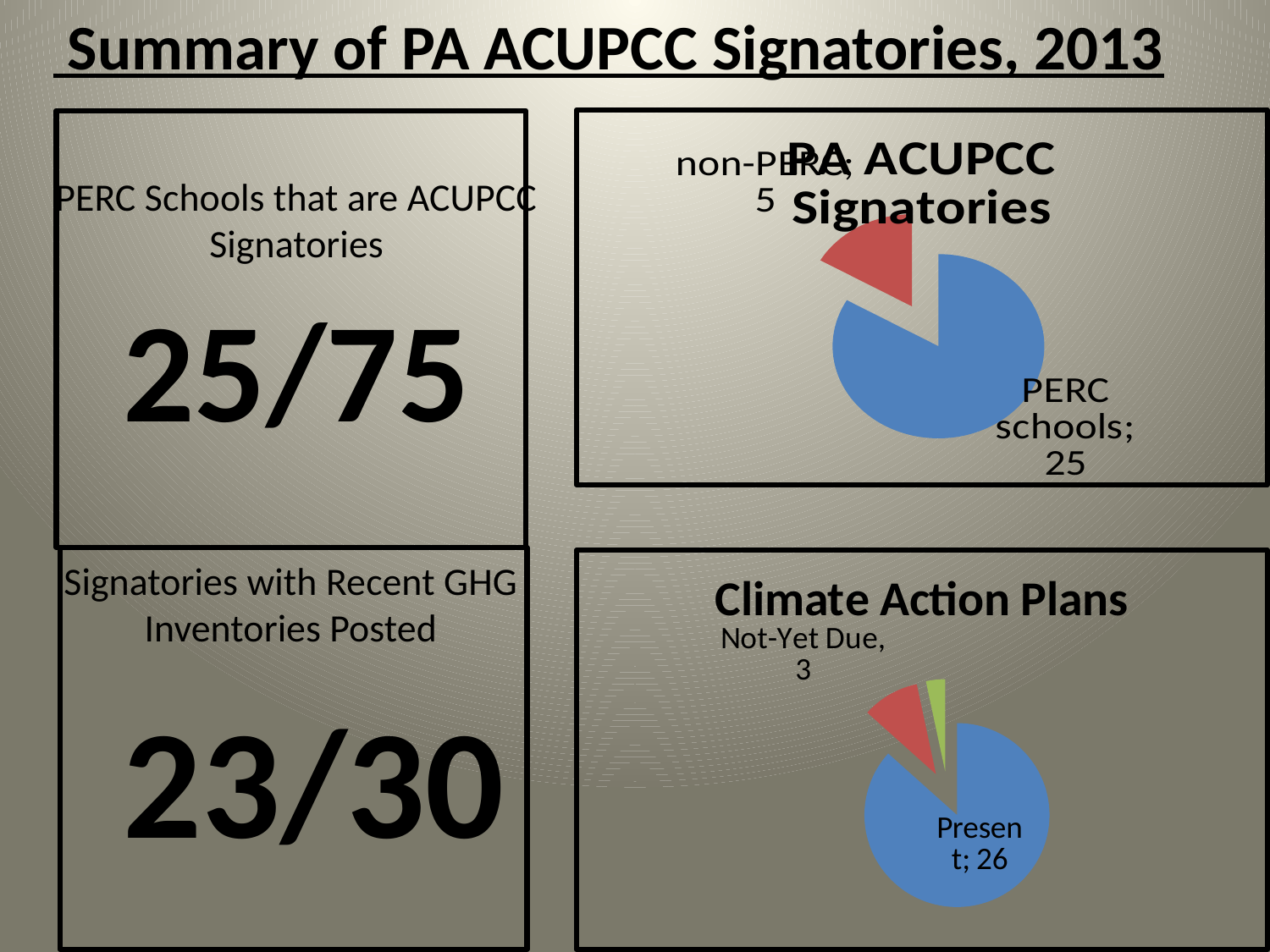
In the PA ACUPCC Signatories chart, which category has the largest slice? PERC schools In the PA ACUPCC Signatories chart, what is the value for non-PERC? 5 In the Climate Action Plans chart, what is the value for Not-Yet Due? 3 In the Climate Action Plans chart, what is the value for Present? 26 In the PA ACUPCC Signatories chart, what is the value for PERC schools? 25 What kind of chart is the PA ACUPCC Signatories chart? Pie chart In the Climate Action Plans chart, which is larger, Present or Not-Yet Due? Present In the Climate Action Plans chart, which category has the largest slice? Present In the PA ACUPCC Signatories chart, which category has the smallest slice? non-PERC How many slices does the Climate Action Plans pie chart have? 3 In the PA ACUPCC Signatories chart, what is the difference between the PERC schools value and the non-PERC value? 20 In the Climate Action Plans chart, what is the difference between the Present value and the Not-Yet Due value? 23